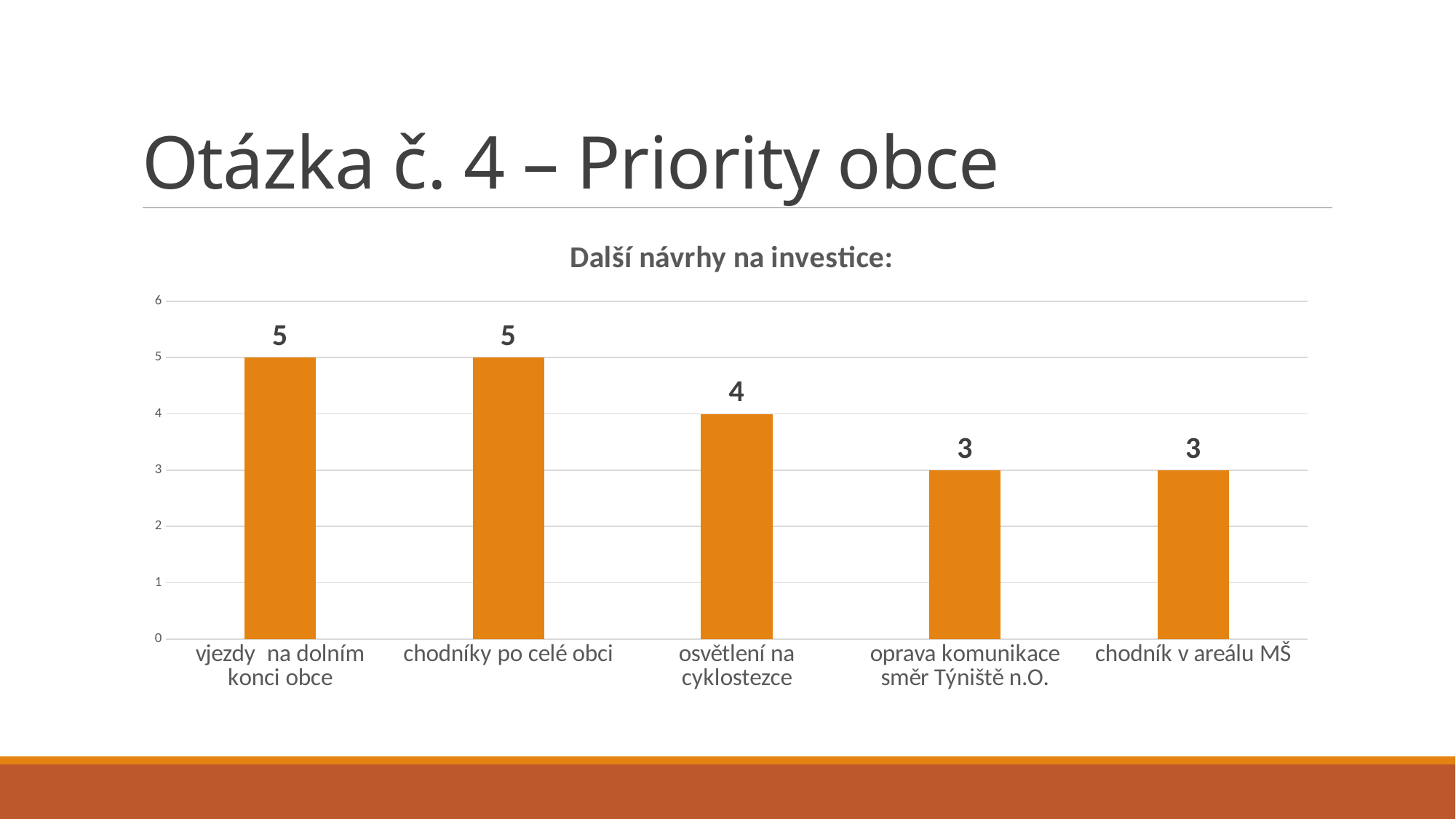
What is the highest value shown on the vertical axis? 6 What kind of chart is shown on the slide? bar chart What is the value for 'oprava komunikace směr Týniště n.O.'? 3 What is the value for 'osvětlení na cyklostezce'? 4 What is the difference between the values for 'vjezdy na dolním konci obce' and 'chodník v areálu MŠ'? 2 What is the value for 'chodník v areálu MŠ'? 3 Do the values rise or fall from left to right along the x axis? fall What is the value for 'vjezdy na dolním konci obce'? 5 What is the difference between the values for 'chodníky po celé obci' and 'osvětlení na cyklostezce'? 1 How many categories are shown in the chart? 5 What is the title of the chart? Další návrhy na investice: Which is larger, the value for 'osvětlení na cyklostezce' or the value for 'oprava komunikace směr Týniště n.O.'? osvětlení na cyklostezce